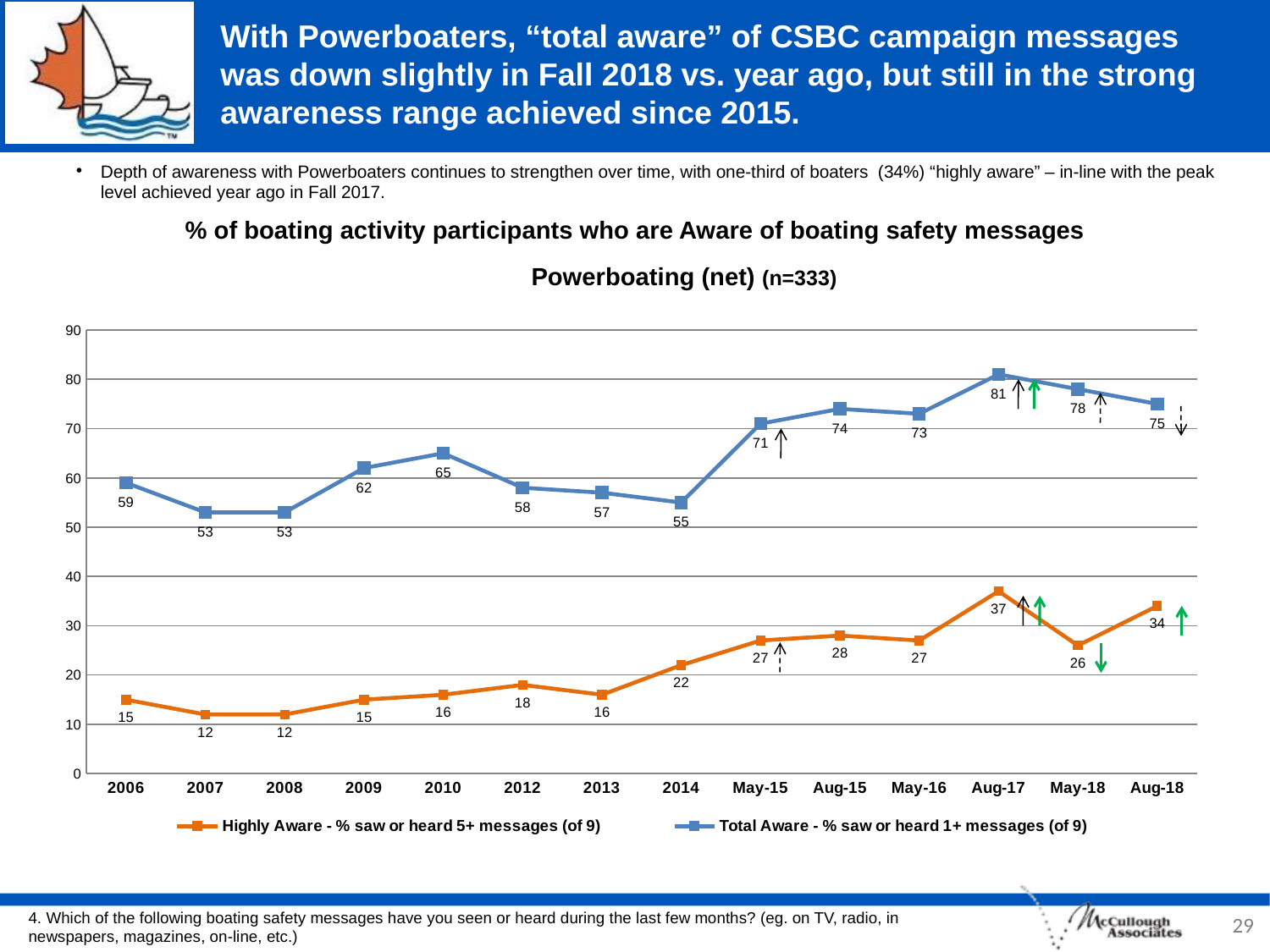
What is the Highly Aware value for May-18? 26 How many time points are plotted along the x axis? 14 What is the Total Aware value for Aug-18? 75 What is the difference between the Total Aware values for Aug-17 and Aug-18? 6 In which periods is the Highly Aware value lowest? 2007 and 2008 What is the Total Aware value for 2010? 65 In which period is the Total Aware value highest? Aug-17 Does the Total Aware series rise or fall from 2014 to May-15? Rise What is the sample size (n) shown in the chart subtitle? n=333 What type of chart is shown on the slide? Line chart Which is larger, the Highly Aware value for Aug-17 or for Aug-18? Aug-17 How many series does the legend list? 2